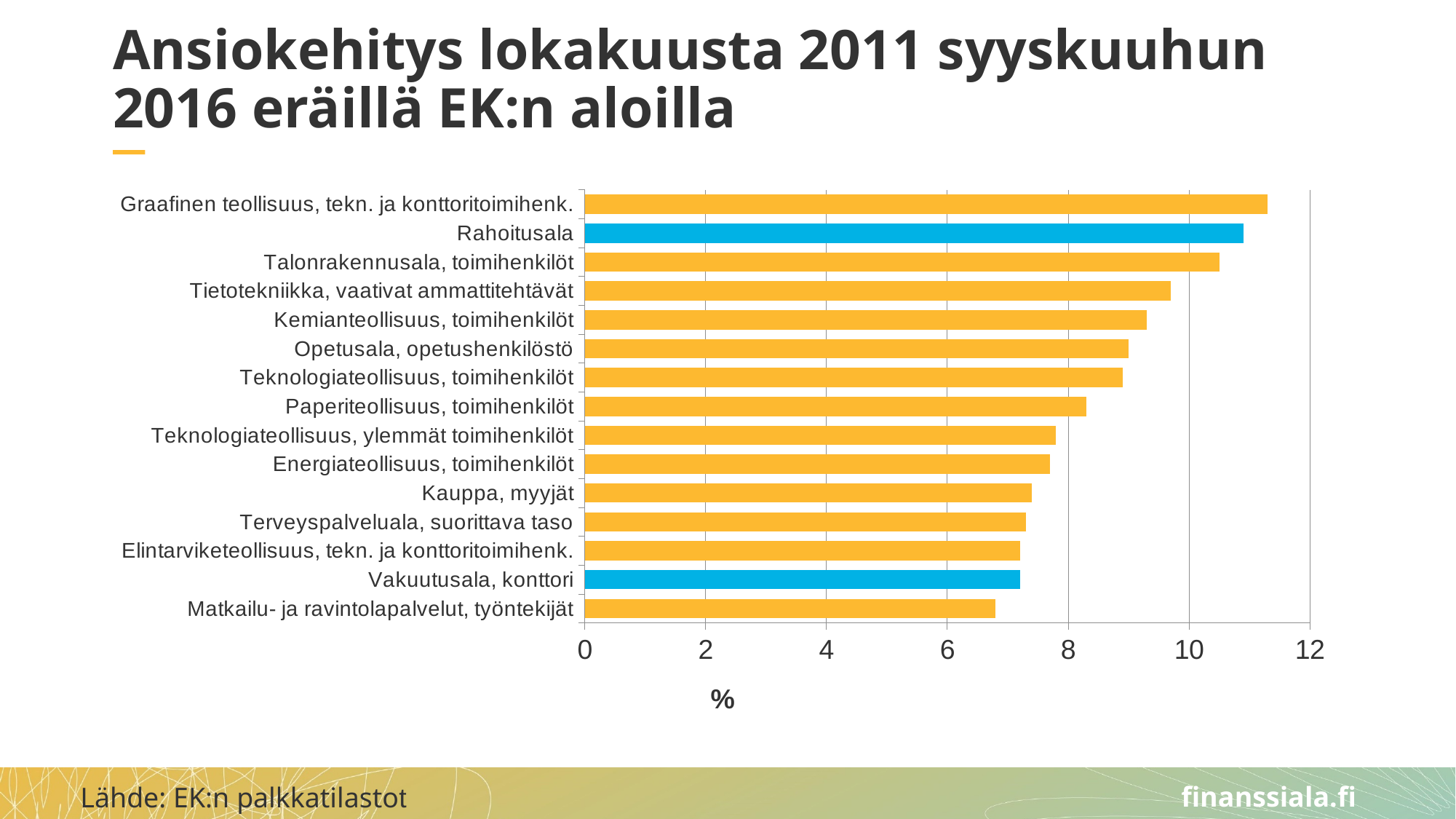
Is the value for Kauppa, myyjät greater or less than 8? less Which has the larger value, Rahoitusala or Vakuutusala, konttori? Rahoitusala Which sector has the highest earnings growth in the chart? Graafinen teollisuus, tekn. ja konttoritoimihenk. Is the value for Matkailu- ja ravintolapalvelut, työntekijät greater or less than 8? less What is the label on the horizontal axis of the chart? % Which has the larger value, Tietotekniikka, vaativat ammattitehtävät or Kauppa, myyjät? Tietotekniikka, vaativat ammattitehtävät How many sectors (categories) are plotted in the chart? 15 What kind of chart is shown on the slide? bar chart Is the value for Talonrakennusala, toimihenkilöt greater or less than 10? greater Which sector has the lowest earnings growth in the chart? Matkailu- ja ravintolapalvelut, työntekijät